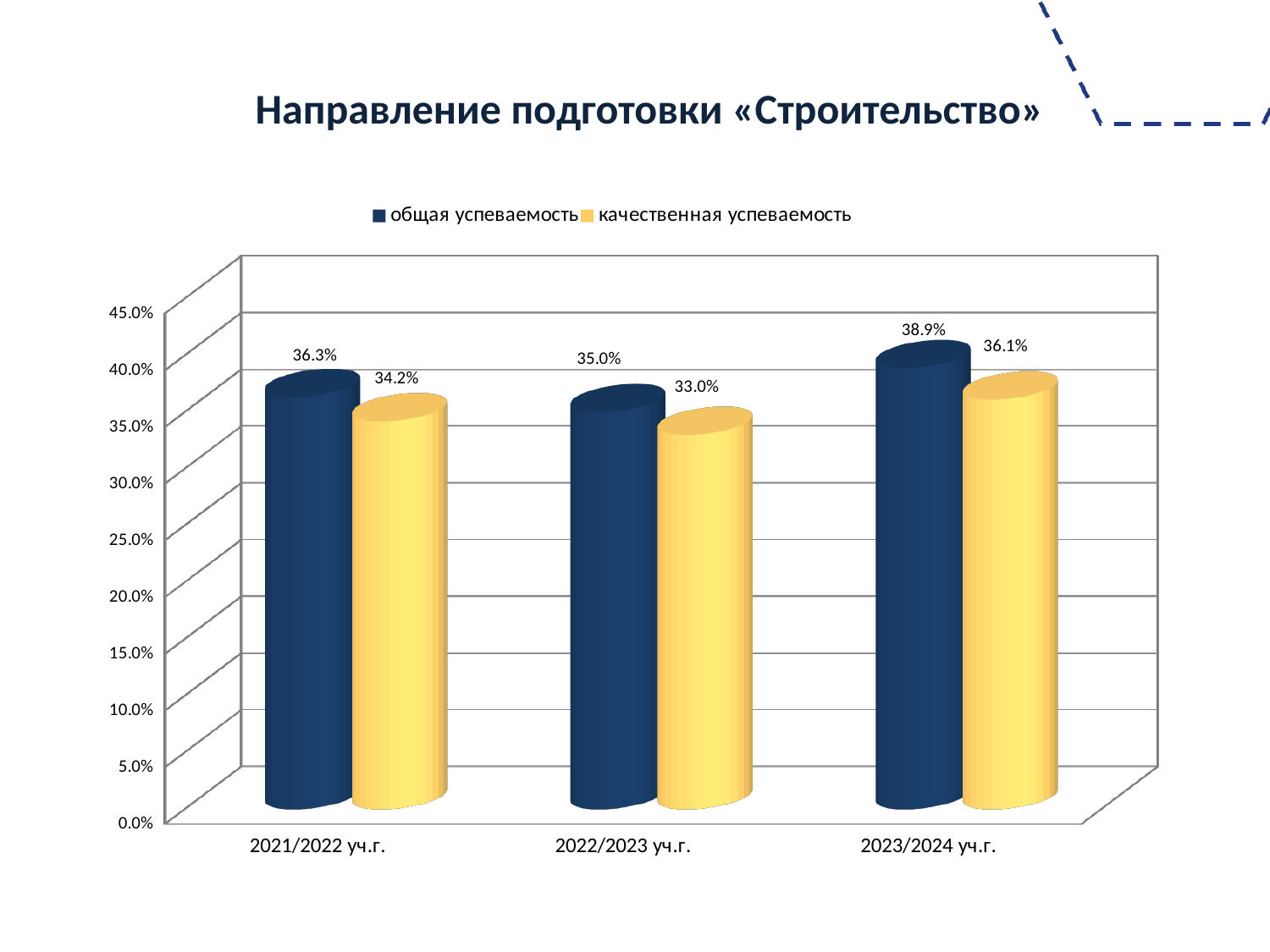
What is the value of общая успеваемость for 2023/2024 уч.г.? 38.9% In which academic year is общая успеваемость highest? 2023/2024 уч.г. What is the value of качественная успеваемость for 2022/2023 уч.г.? 33.0% What is the value of общая успеваемость for 2021/2022 уч.г.? 36.3% What is the title of the slide? Направление подготовки «Строительство» Which is larger in 2021/2022 уч.г.: общая успеваемость or качественная успеваемость? общая успеваемость How many academic years are shown on the x axis? 3 In which academic year is качественная успеваемость lowest? 2022/2023 уч.г. What is the value of качественная успеваемость for 2023/2024 уч.г.? 36.1% What is the difference between общая успеваемость and качественная успеваемость in 2023/2024 уч.г.? 2.8% What kind of chart is shown on the slide? bar chart How many series does the legend list? 2